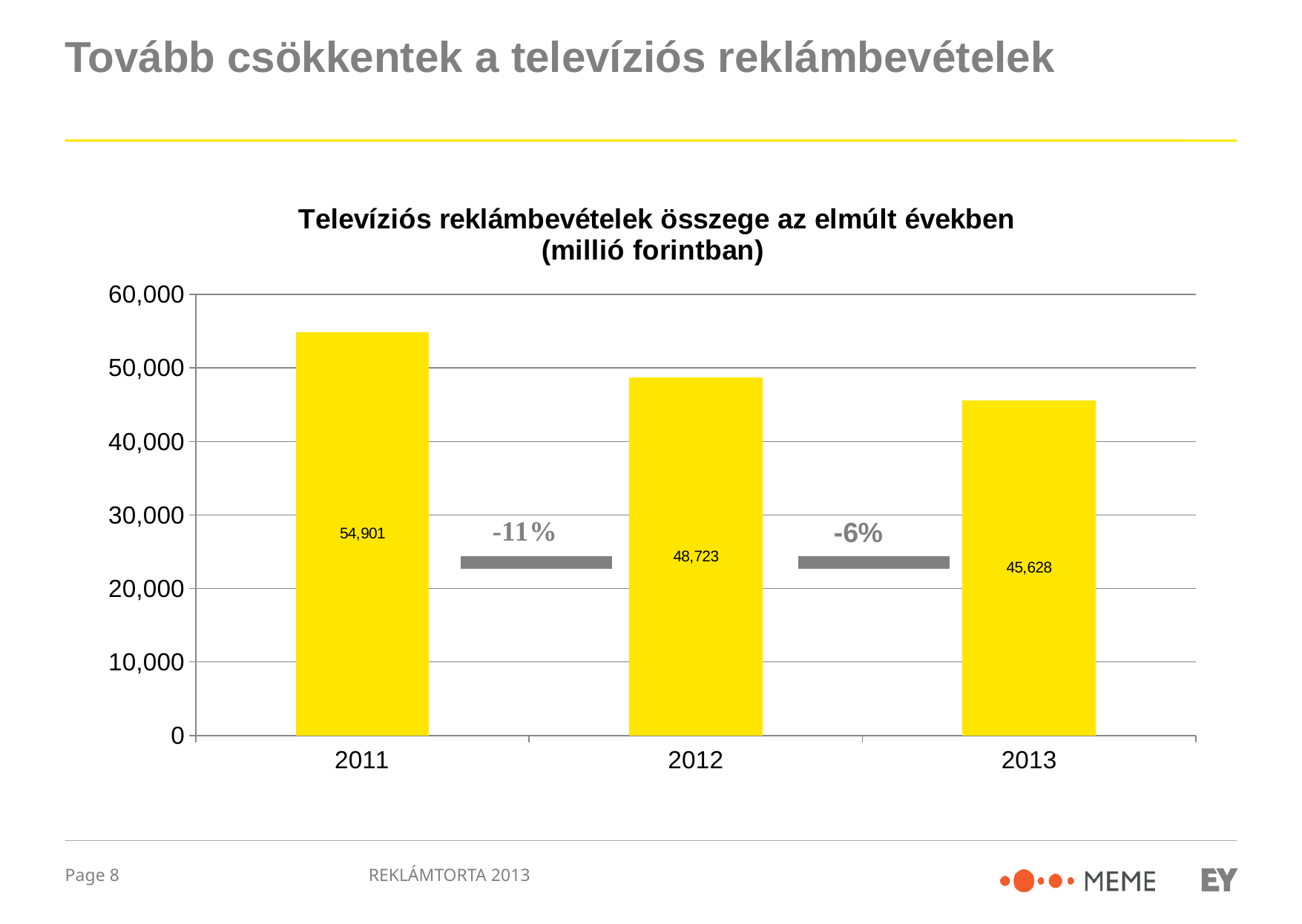
How many years are shown on the chart? 3 What is the difference between the values for 2012 and 2013? 3,095 Which year has the lowest value? 2013 Is the value for 2013 greater or less than 50,000? less Do the values rise or fall from 2011 to 2013? fall What kind of chart is shown on the slide? bar chart What is the value for 2013? 45,628 Which year has the highest value? 2011 What is the value for 2011? 54,901 What is the value for 2012? 48,723 Which is larger, the value for 2012 or the value for 2013? 2012 What is the difference between the values for 2011 and 2012? 6,178